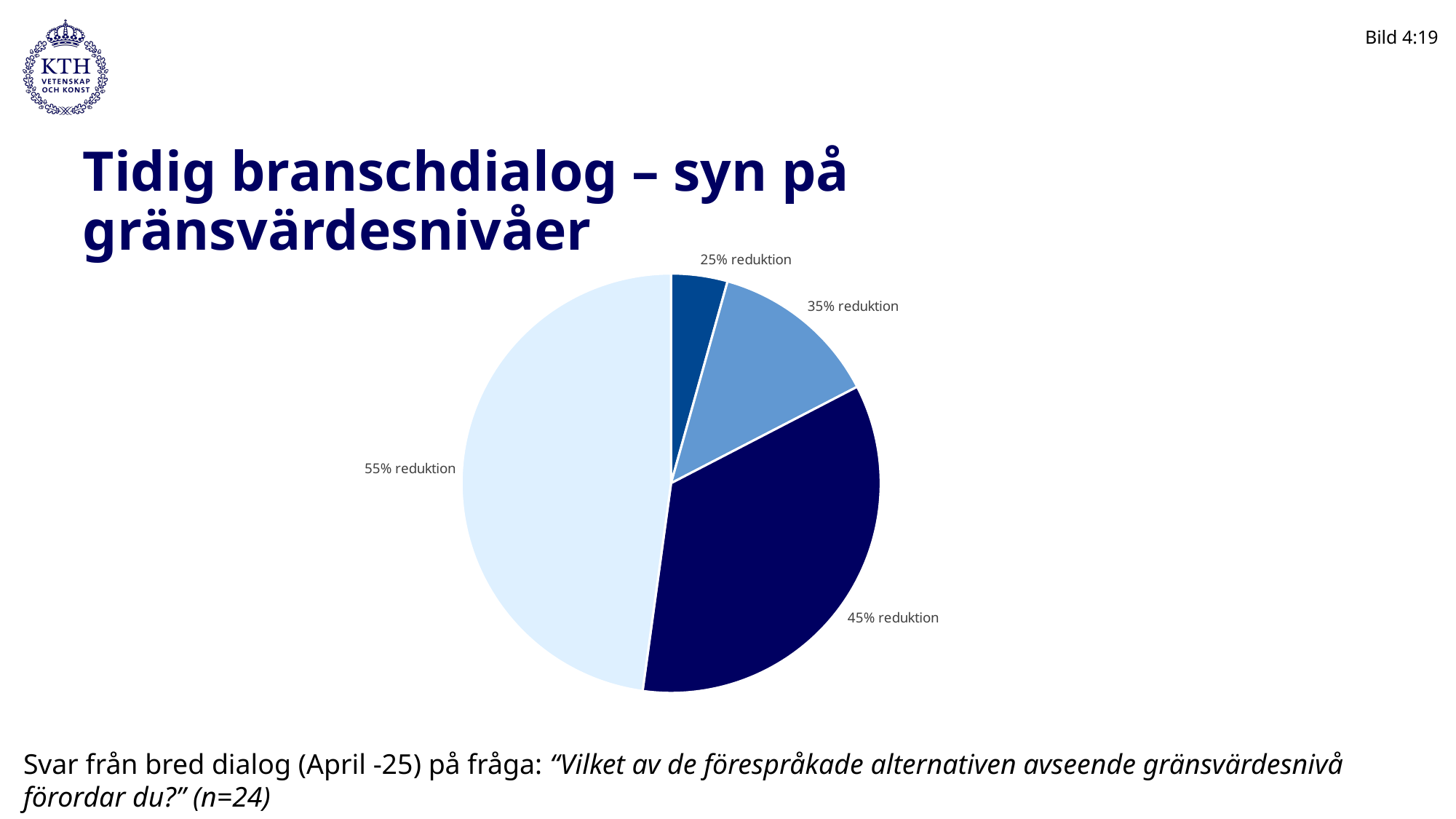
What is the title of the slide containing the pie chart? Tidig branschdialog – syn på gränsvärdesnivåer Which slice is larger, 55% reduktion or 45% reduktion? 55% reduktion Which category has the smallest slice of the pie chart? 25% reduktion What kind of chart is shown on the slide? pie chart Which category has the largest slice of the pie chart? 55% reduktion Which slice is larger, 45% reduktion or 35% reduktion? 45% reduktion According to the note below the chart, how many respondents (n) answered the question? 24 Which category has the second-largest slice of the pie chart? 45% reduktion Which slice is larger, 35% reduktion or 25% reduktion? 35% reduktion How many slices does the pie chart have? 4